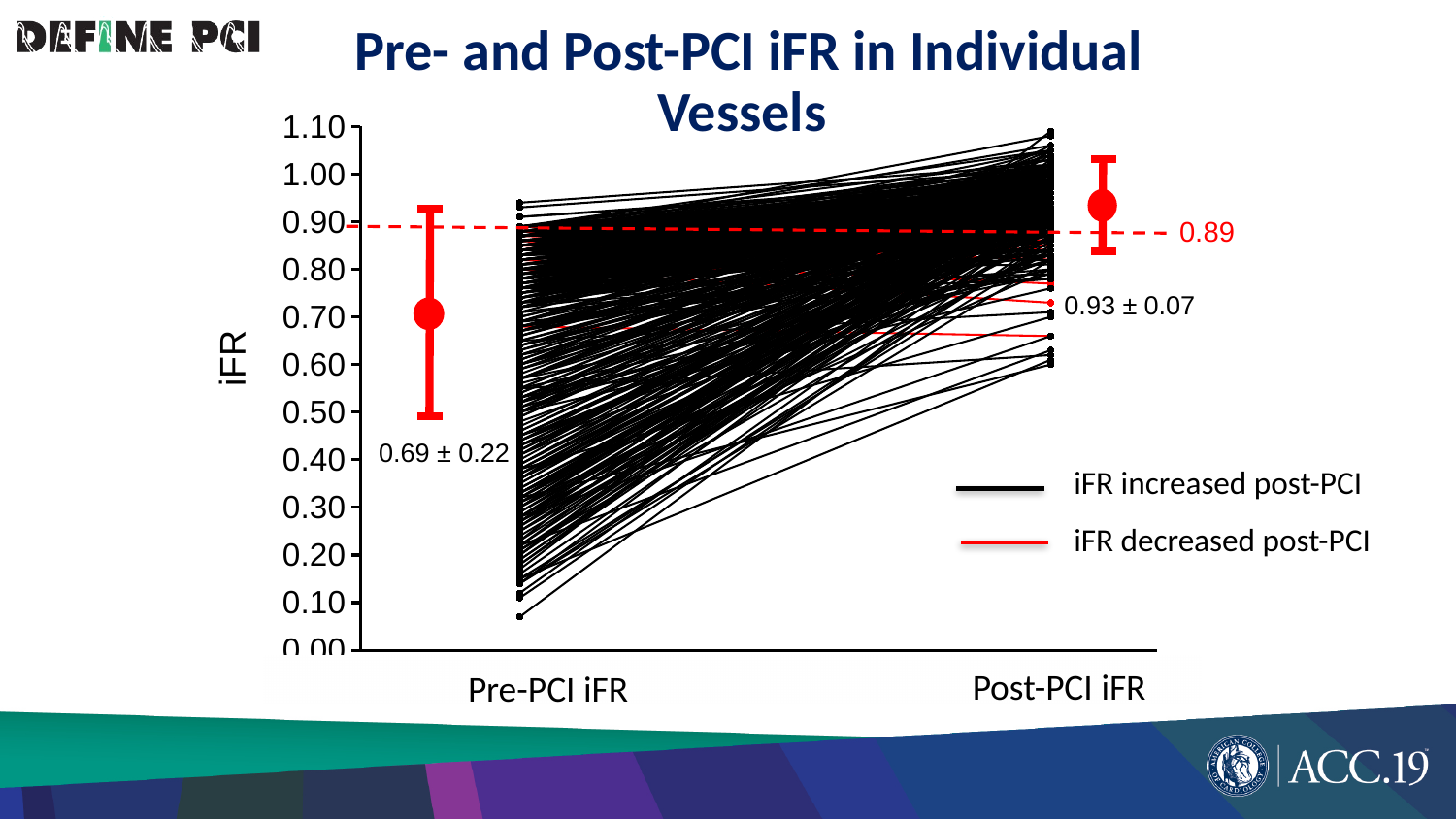
How many entries does the legend list? 2 What iFR value is marked by the red dashed horizontal line? 0.89 What do the red lines represent according to the legend? iFR decreased post-PCI How many categories are shown on the x axis? 2 What is the difference between the mean post-PCI iFR (0.93) and the mean pre-PCI iFR (0.69)? 0.24 Do the mean iFR values rise or fall from Pre-PCI iFR to Post-PCI iFR? rise What is the mean post-PCI iFR value printed on the chart? 0.93 ± 0.07 What do the black lines represent according to the legend? iFR increased post-PCI Which has the higher mean iFR, Pre-PCI iFR or Post-PCI iFR? Post-PCI iFR What kind of chart is shown on the slide? line chart Is the mean pre-PCI iFR greater or less than 0.80? less What is the mean pre-PCI iFR value printed on the chart? 0.69 ± 0.22